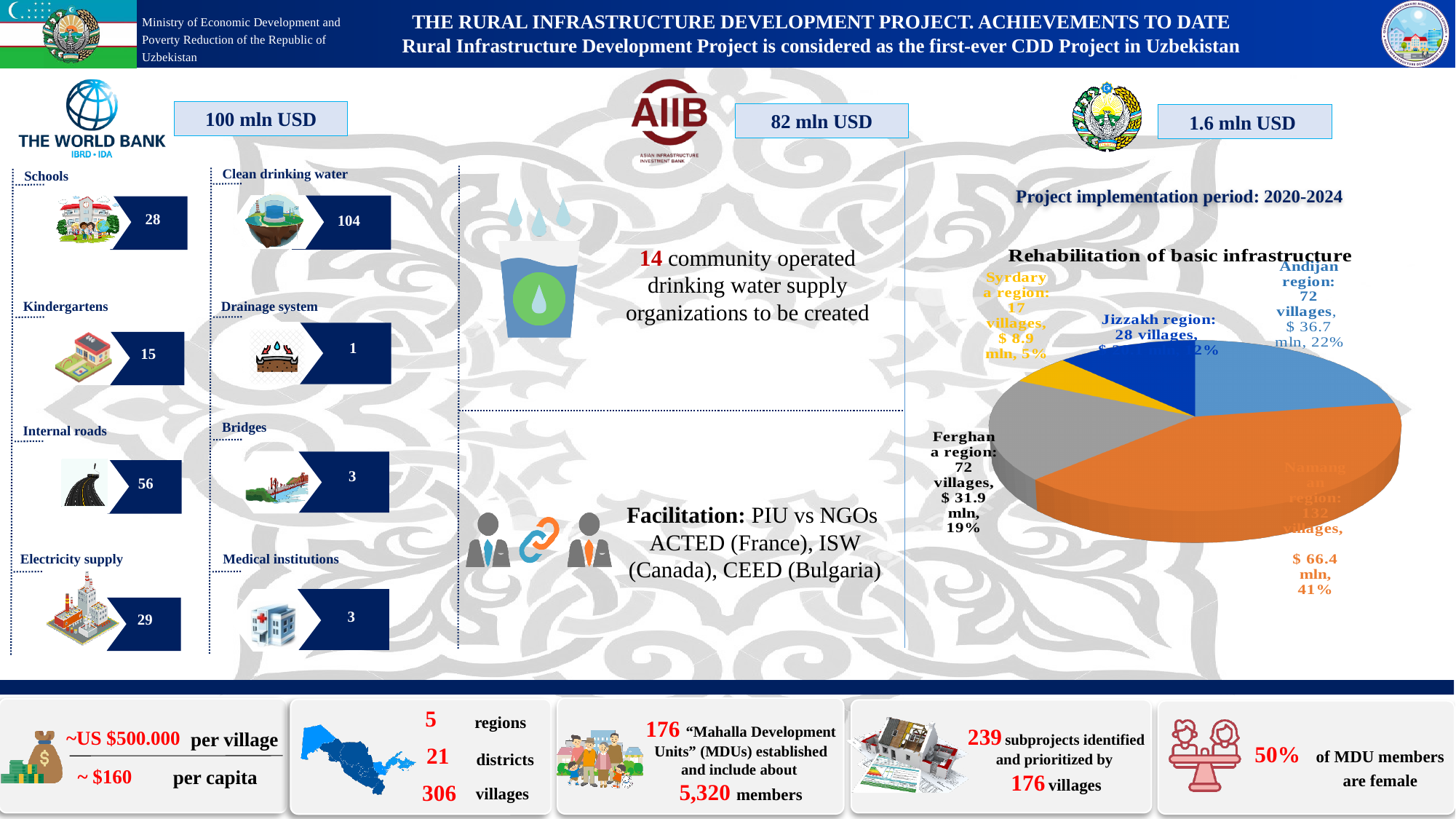
In the 'Rehabilitation of basic infrastructure' pie chart, what is the dollar amount for Andijan region? $ 36.7 mln In the 'Rehabilitation of basic infrastructure' pie chart, which region has the largest share? Namangan region In the 'Rehabilitation of basic infrastructure' pie chart, what is the dollar amount for Syrdarya region? $ 8.9 mln What kind of chart is used for 'Rehabilitation of basic infrastructure'? pie chart In the 'Rehabilitation of basic infrastructure' pie chart, how many villages are listed for Ferghana region? 72 villages In the 'Rehabilitation of basic infrastructure' pie chart, how many percentage points larger is Namangan region's share than Andijan region's share? 19 percentage points How many regions (slices) are shown in the 'Rehabilitation of basic infrastructure' pie chart? 5 In the 'Rehabilitation of basic infrastructure' pie chart, how many villages are listed for Syrdarya region? 17 villages In the 'Rehabilitation of basic infrastructure' pie chart, what share does Namangan region have? 41% In the 'Rehabilitation of basic infrastructure' pie chart, how many more villages does Namangan region have than Ferghana region? 60 In the 'Rehabilitation of basic infrastructure' pie chart, which has the larger share: Andijan region or Ferghana region? Andijan region In the 'Rehabilitation of basic infrastructure' pie chart, which region has the smallest share? Syrdarya region